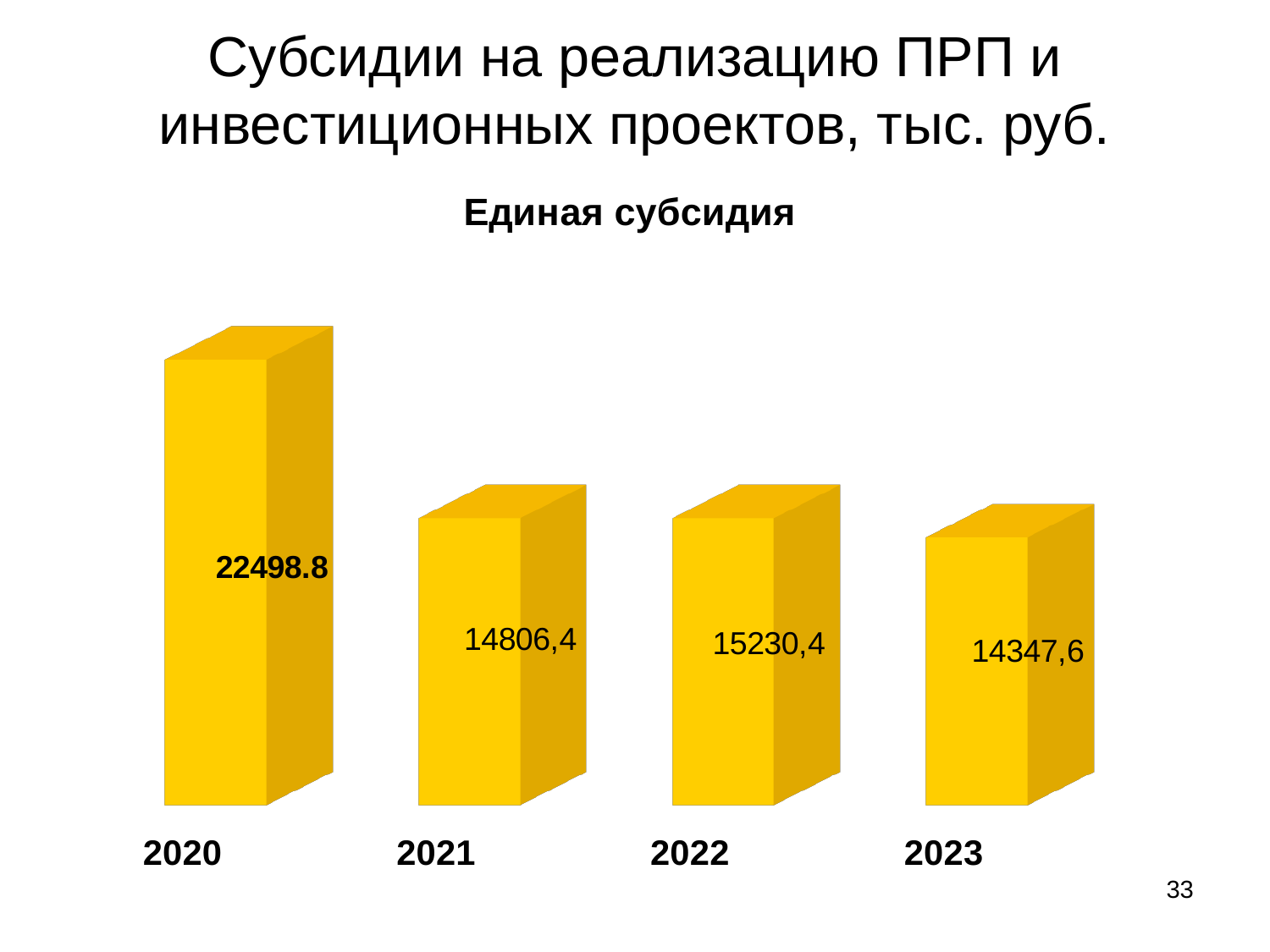
What is the value for 2021? 14806,4 What is the value for 2022? 15230,4 How many years are shown in the chart? 4 What is the difference between the values for 2021 and 2023? 458,8 What kind of chart is shown on the slide? Bar chart Which is larger, the value for 2021 or the value for 2022? 2022 What is the title of the chart? Единая субсидия What is the difference between the values for 2022 and 2021? 424 What is the value for 2023? 14347,6 Which year has the lowest value? 2023 Which year has the highest value? 2020 What is the value for 2020? 22498.8